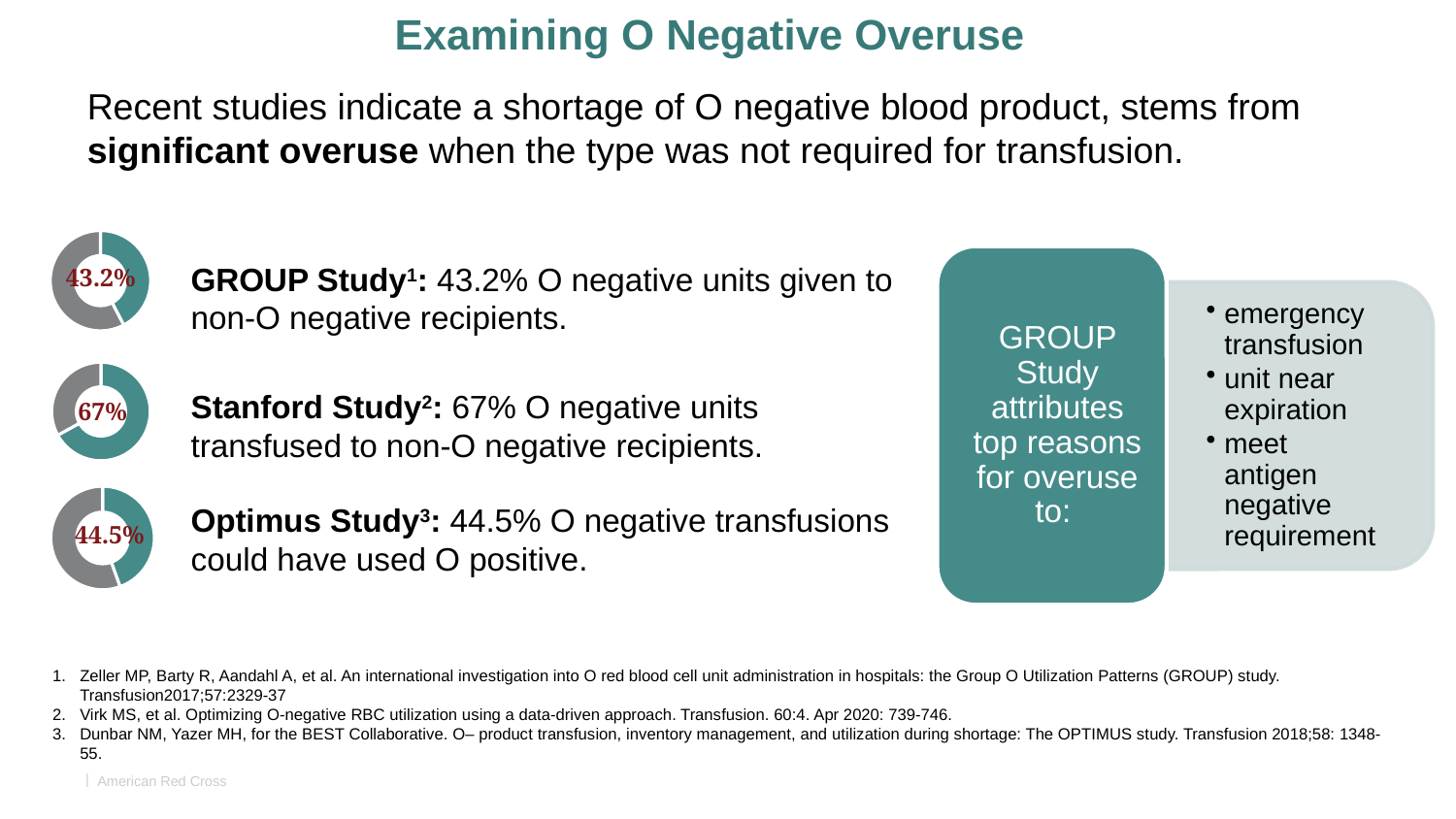
What share of the middle donut chart does the highlighted (teal) slice represent? 67% What colour is the highlighted slice in each of the three donut charts? Teal What percentage is shown on the bottom donut chart next to the Optimus Study? 44.5% What is the difference between the Stanford Study percentage and the GROUP Study percentage shown on the donut charts? 23.8% What is the difference between the Optimus Study percentage and the GROUP Study percentage shown on the donut charts? 1.3% What percentage is shown on the top donut chart next to the GROUP Study? 43.2% How many donut charts are shown on the slide? 3 What percentage is shown on the middle donut chart next to the Stanford Study? 67% What kind of chart is used to display the percentages for the three studies? Donut (pie) chart Which study's donut chart shows the highest percentage? Stanford Study (67%) Which study's donut chart shows the lowest percentage? GROUP Study (43.2%) Which is larger, the percentage on the Stanford Study donut chart or the percentage on the Optimus Study donut chart? Stanford Study